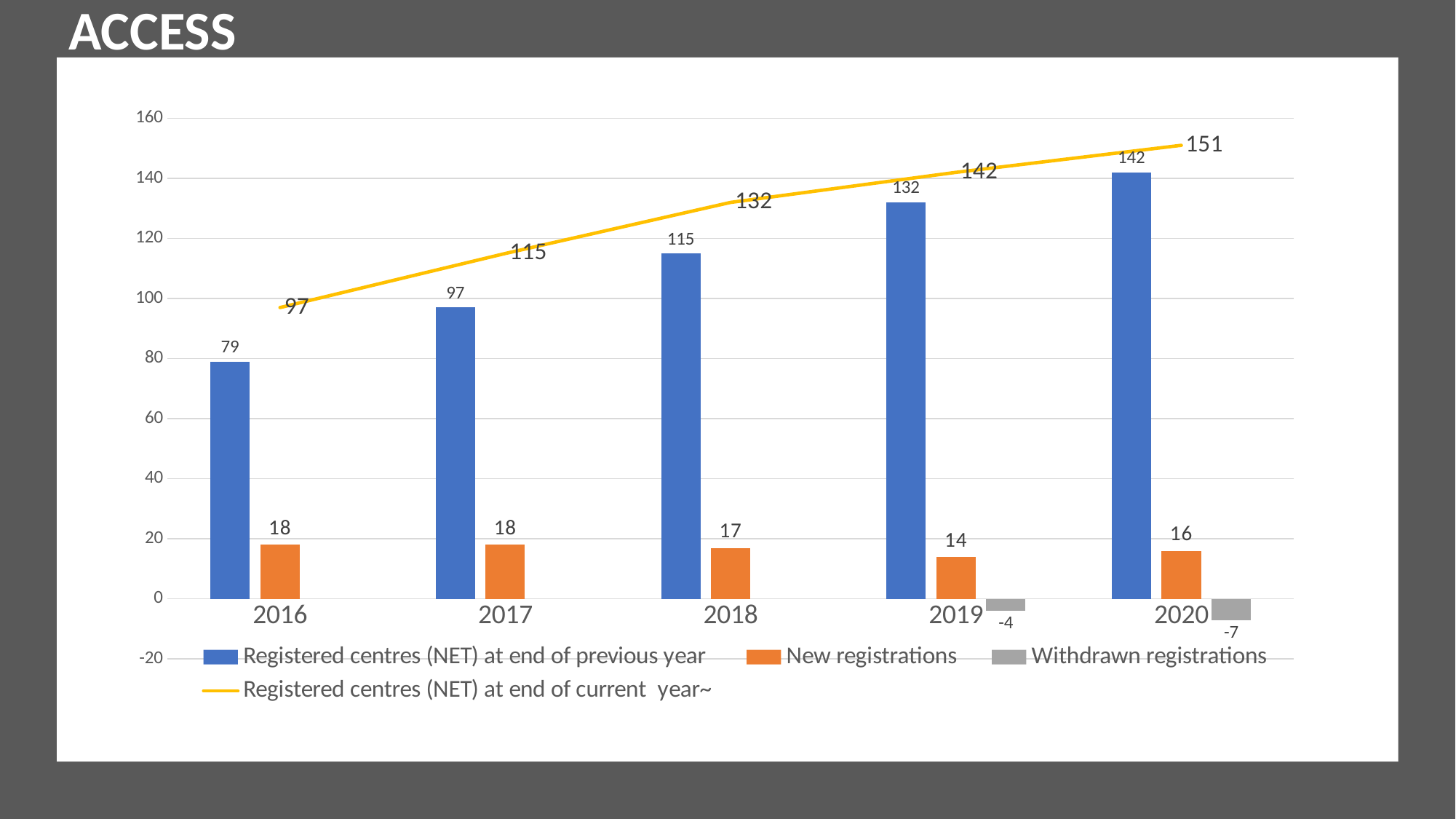
Which year has the highest value for Registered centres (NET) at end of current year? 2020 How many series does the legend list? 4 What colour are the New registrations bars? orange What is the value of Registered centres (NET) at end of previous year for 2016? 79 Which is larger: New registrations for 2019 or New registrations for 2020? 2020 Does the Registered centres (NET) at end of current year line rise or fall from 2016 to 2020? rise What is the value of Withdrawn registrations for 2020? -7 What is the value of New registrations for 2018? 17 What is the value of Registered centres (NET) at end of current year for 2019? 142 How many years are shown on the x axis? 5 Which year has the lowest value for New registrations? 2019 What is the difference between Registered centres (NET) at end of previous year for 2020 and 2016? 63